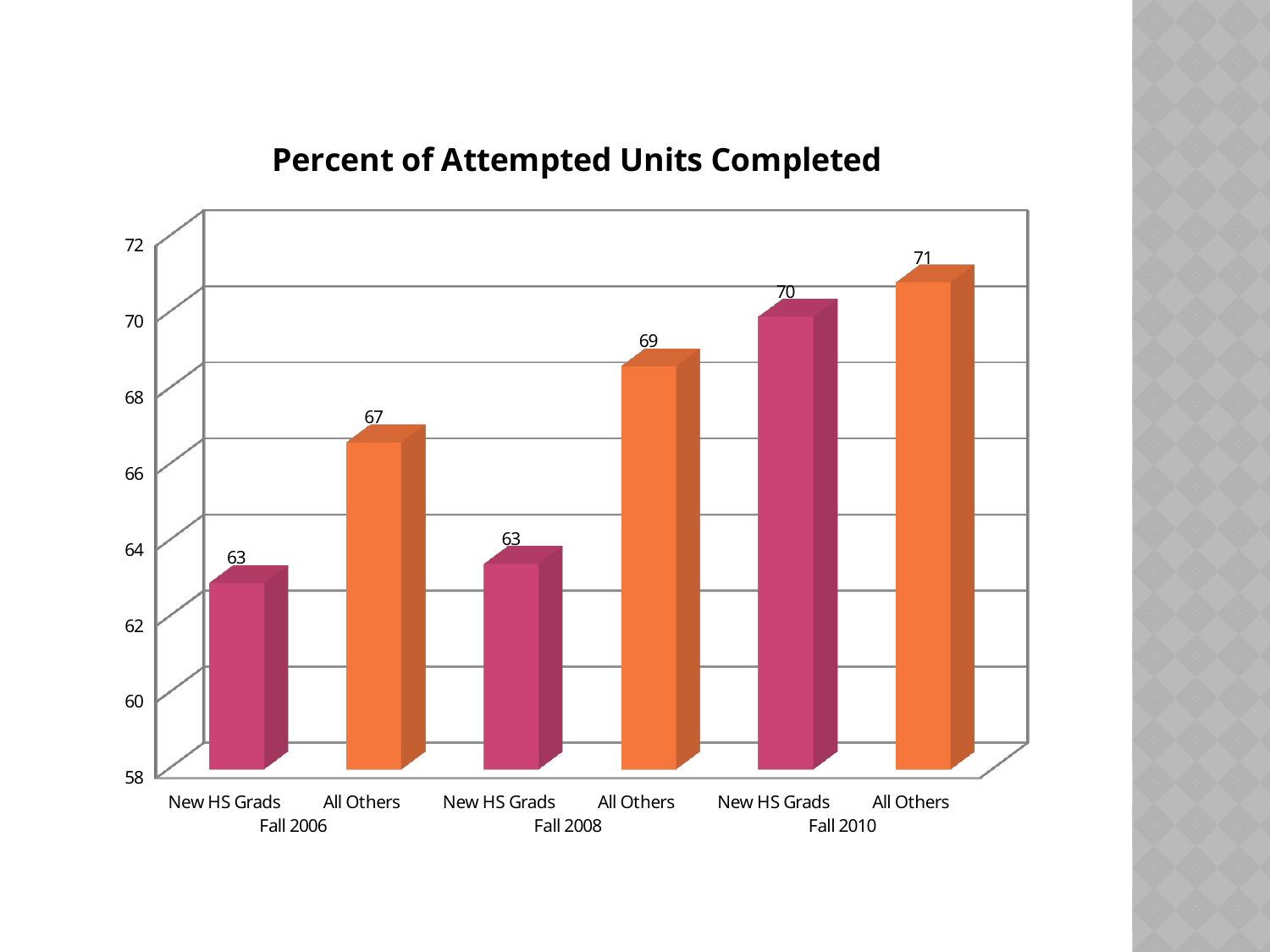
What is the title of the chart? Percent of Attempted Units Completed What kind of chart is shown? bar chart Which bar has the highest value? All Others, Fall 2010 What is the value for All Others in Fall 2008? 69 How many bars are plotted in the chart? 6 What is the difference between All Others and New HS Grads in Fall 2006? 4 Is the value for New HS Grads in Fall 2010 greater or less than 68? greater What is the difference between All Others and New HS Grads in Fall 2008? 6 Do the values for New HS Grads rise or fall from Fall 2006 to Fall 2010? rise What is the value for New HS Grads in Fall 2006? 63 What is the value for All Others in Fall 2010? 71 Which is larger, New HS Grads in Fall 2010 or All Others in Fall 2008? New HS Grads in Fall 2010